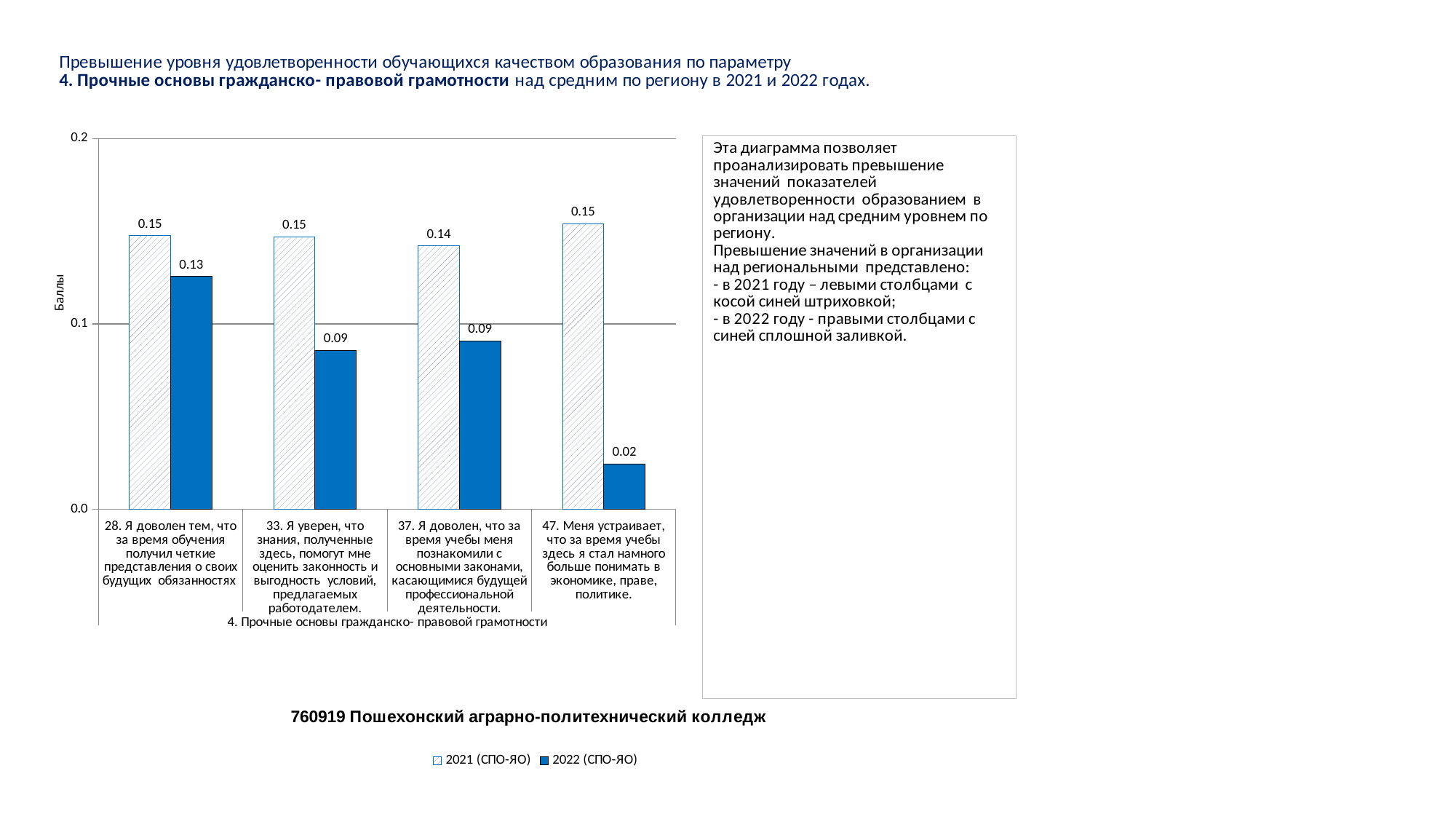
What is the difference between the 2021 and 2022 values for item 33? 0.06 Which item has the lowest 2022 (СПО-ЯО) value? 47. Меня устраивает, что за время учебы здесь я стал намного больше понимать в экономике, праве, политике. What is the 2021 (СПО-ЯО) value for item 37 (Я доволен, что за время учебы меня познакомили с основными законами)? 0.14 What is the difference between the 2021 and 2022 values for item 47? 0.13 Which item has the lowest 2021 (СПО-ЯО) value? 37. Я доволен, что за время учебы меня познакомили с основными законами, касающимися будущей профессиональной деятельности. Which item has the highest 2022 (СПО-ЯО) value? 28. Я доволен тем, что за время обучения получил четкие представления о своих будущих обязанностях What is the 2022 (СПО-ЯО) value for item 28 (Я доволен тем, что за время обучения получил четкие представления о своих будущих обязанностях)? 0.13 How many series does the legend list? 2 For item 28, which is larger: the 2021 (СПО-ЯО) value or the 2022 (СПО-ЯО) value? 2021 (СПО-ЯО) Is the 2022 (СПО-ЯО) value for item 47 greater or less than 0.1? less How many items (categories) are shown on the x axis of the chart? 4 What is the 2022 (СПО-ЯО) value for item 47 (Меня устраивает, что за время учебы здесь я стал намного больше понимать в экономике, праве, политике)? 0.02